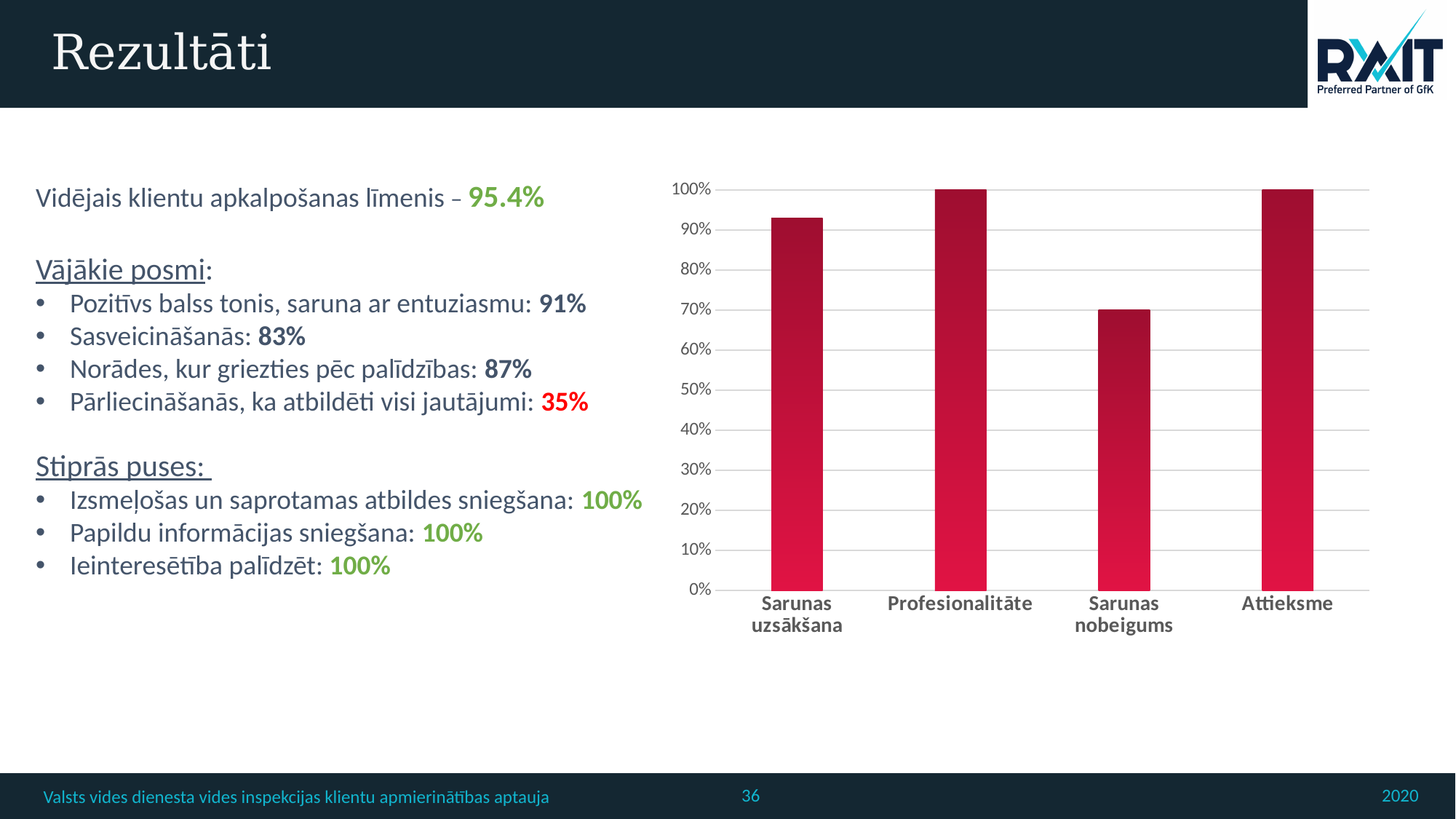
What is the value for Profesionalitāte in the chart? 100% Is the value for Sarunas uzsākšana greater or less than 90%? greater How many categories are shown on the x axis of the chart? 4 What is the highest value shown on the y axis of the chart? 100% What is the value for Sarunas nobeigums in the chart? 70% What is the value for Attieksme in the chart? 100% What kind of chart is shown on the slide? bar chart Which is larger in the chart: Sarunas uzsākšana or Sarunas nobeigums? Sarunas uzsākšana Which is larger in the chart: Profesionalitāte or Sarunas uzsākšana? Profesionalitāte Is the value for Sarunas nobeigums greater or less than 80%? less What is the difference between the values for Profesionalitāte and Sarunas nobeigums? 30% Which category has the lowest bar in the chart? Sarunas nobeigums